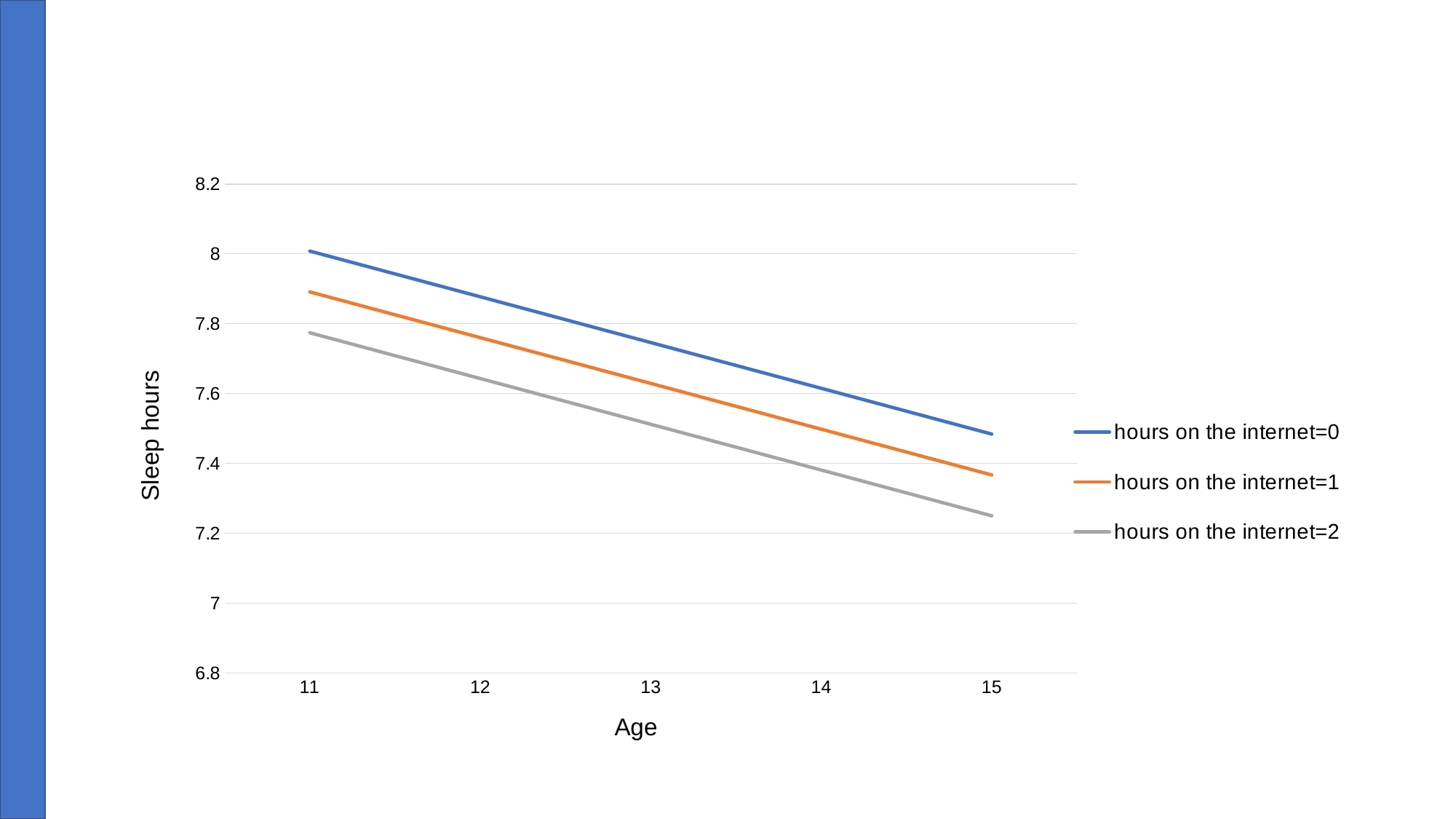
How many series does the legend list? 3 Is the value for hours on the internet=2 at age 15 greater or less than 7.4? less Is the value for hours on the internet=1 at age 11 greater or less than 7.8? greater How many age values are shown on the x axis? 5 At age 13, which series has more sleep hours: hours on the internet=0 or hours on the internet=2? hours on the internet=0 Do the sleep hours rise or fall as age increases from 11 to 15? fall What is the label of the y axis? Sleep hours What kind of chart is shown on the slide? line chart What colour is the line for hours on the internet=1? orange Is the value for hours on the internet=0 at age 15 greater or less than 7.4? greater Which series has the lowest sleep hours at every age? hours on the internet=2 Which series has the highest sleep hours at every age? hours on the internet=0